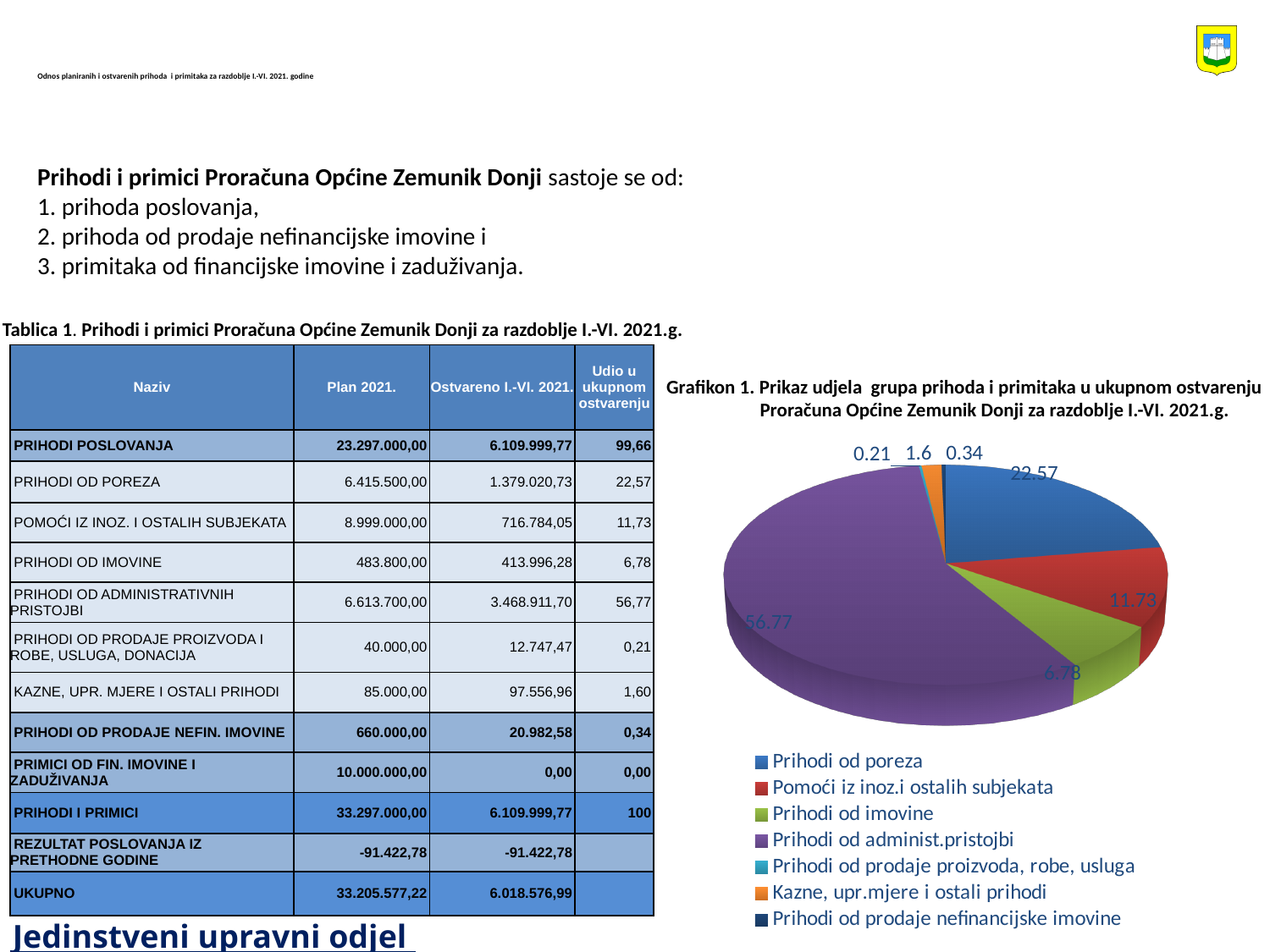
Which category has the smallest slice in the pie chart? Prihodi od prodaje proizvoda, robe, usluga What is the value shown for Prihodi od imovine in the pie chart? 6.78 What is the value shown for Prihodi od administ.pristojbi in the pie chart? 56.77 Which category has the largest slice in the pie chart? Prihodi od administ.pristojbi How many categories does the pie chart's legend list? 7 What is the value shown for Prihodi od poreza in the pie chart? 22.57 What is the number of the chart (Grafikon) shown on the slide? Grafikon 1 What is the value shown for Kazne, upr.mjere i ostali prihodi in the pie chart? 1.6 Which is larger in the pie chart: Prihodi od poreza or Pomoći iz inoz.i ostalih subjekata? Prihodi od poreza What is the difference between the values for Prihodi od administ.pristojbi and Prihodi od poreza in the pie chart? 34.2 What type of chart is shown on the slide? pie chart What is the value shown for Pomoći iz inoz.i ostalih subjekata in the pie chart? 11.73